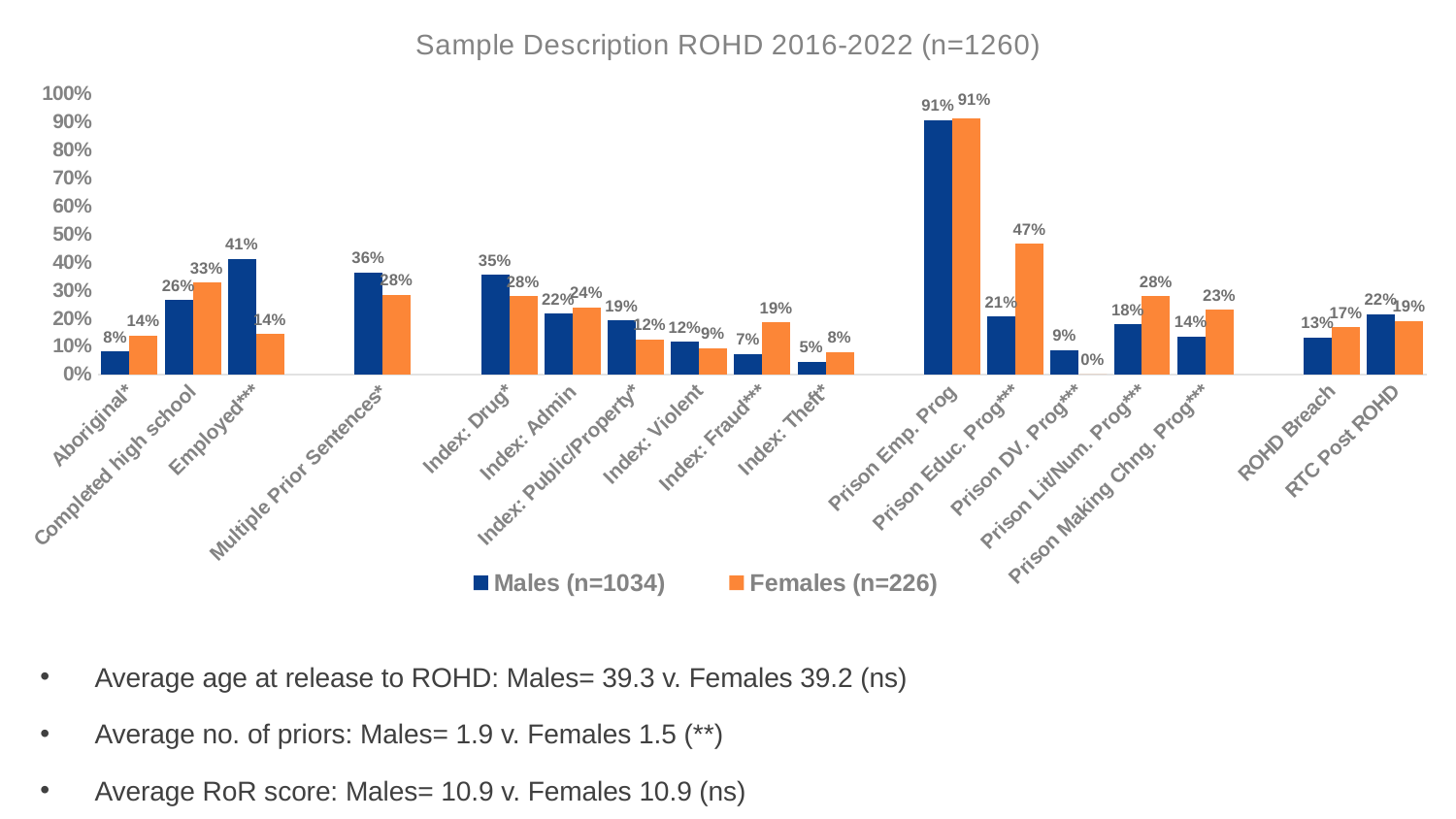
What is the Females value for Prison Educ. Prog***? 47% What is the difference between the Females and Males values for Prison Educ. Prog***? 26% What is the Males value for Employed***? 41% How many series does the legend list? 2 Which is larger for Index: Drug*, the Males value or the Females value? Males Which category has the highest Males value? Prison Emp. Prog What is the Males value for Multiple Prior Sentences*? 36% What is the Females value for Index: Fraud***? 19% What is the title of the chart? Sample Description ROHD 2016-2022 (n=1260) Which category has the lowest Females value? Prison DV. Prog*** What kind of chart is this? Bar chart How many categories are shown on the x axis? 17